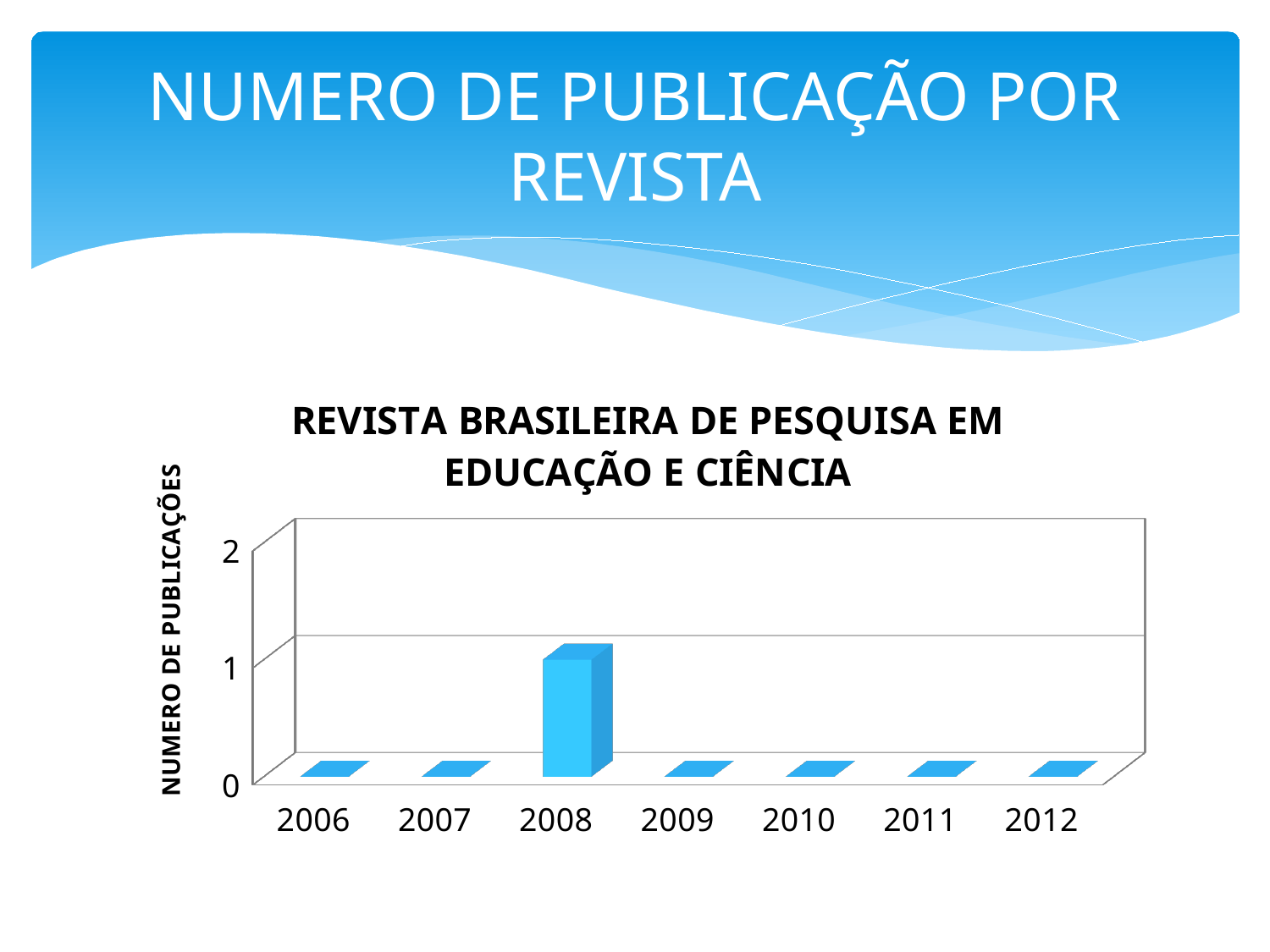
What is the title of the chart? REVISTA BRASILEIRA DE PESQUISA EM EDUCAÇÃO E CIÊNCIA Which year has the highest number of publications? 2008 Which is larger, the value for 2008 or the value for 2012? 2008 What is the highest value shown on the vertical axis? 2 What is the number of publications for 2008? 1 What is the difference between the values for 2008 and 2007? 1 Is the value for 2008 greater or less than 2? less What type of chart is shown on the slide? bar chart What is the label of the vertical axis? NUMERO DE PUBLICAÇÕES What is the number of publications for 2006? 0 How many years are shown on the x axis of the chart? 7 What is the number of publications for 2010? 0